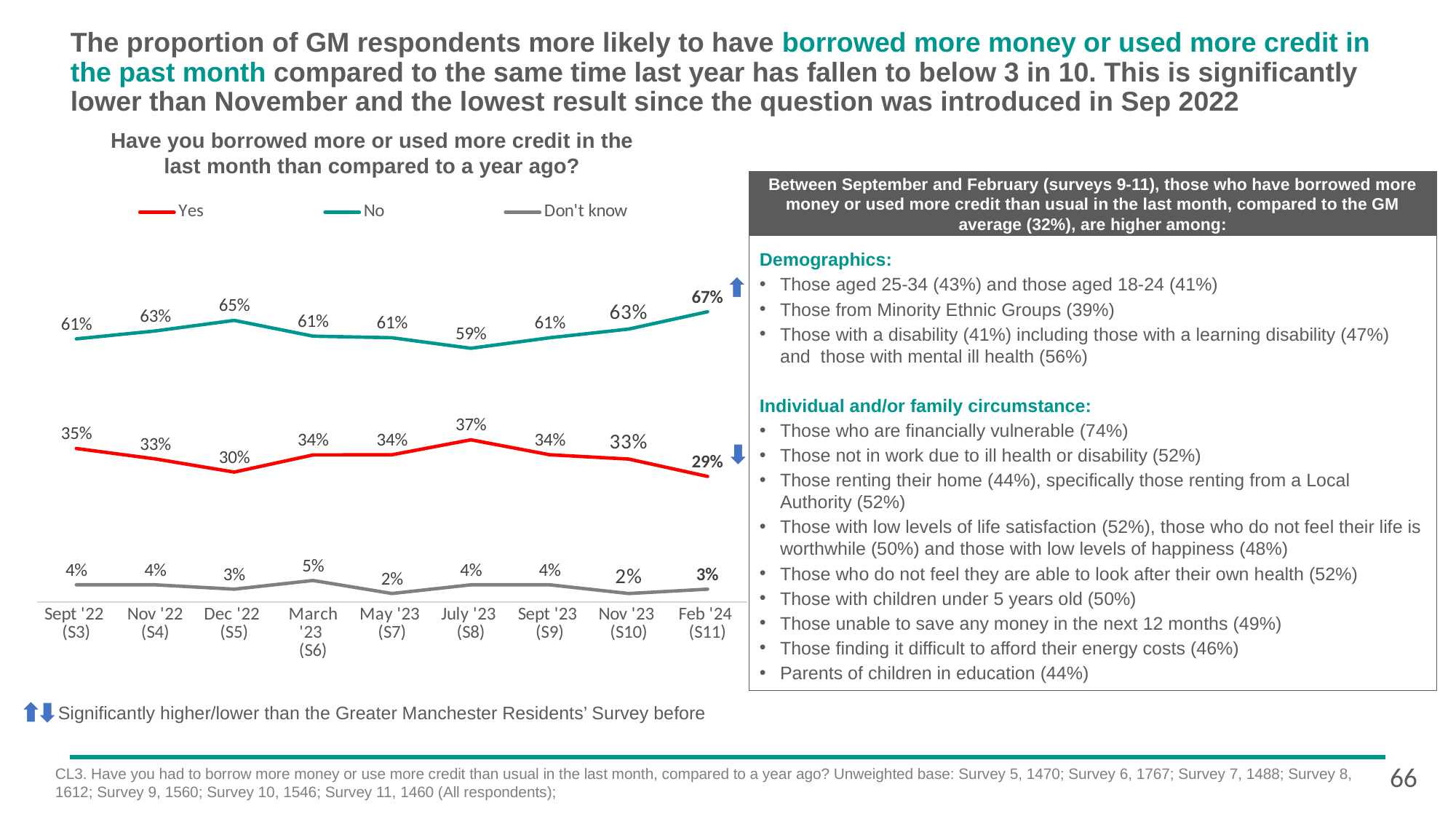
In which survey wave was the 'Yes' series at its highest? July '23 (S8) What type of chart is used to show the survey responses? Line chart What is the difference between the 'No' and 'Yes' values in Feb '24 (S11)? 38 percentage points What percentage of respondents answered 'Yes' in Feb '24 (S11)? 29% What colour is the 'Yes' line in the chart? Red What percentage of respondents answered 'No' in July '23 (S8)? 59% By how many percentage points did the 'Yes' value fall from Nov '23 (S10) to Feb '24 (S11)? 4 percentage points How many series does the chart legend list? 3 How many survey waves are shown on the x axis of the chart? 9 In which survey wave was the 'No' series at its lowest? July '23 (S8) What percentage of respondents answered 'Don't know' in March '23 (S6)? 5% Which was higher for 'Yes': Sept '22 (S3) or Dec '22 (S5)? Sept '22 (S3)